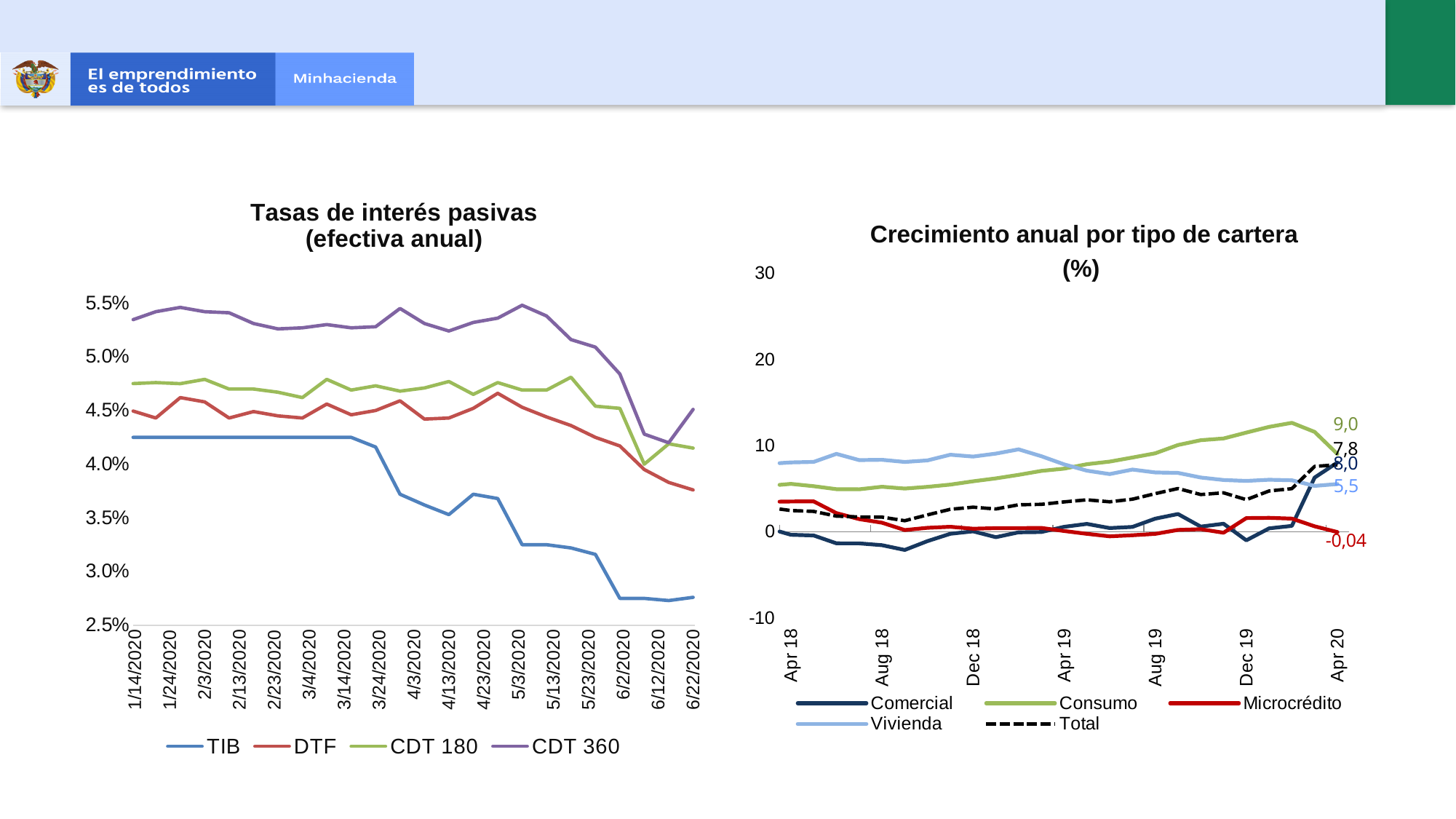
How many series does the legend of the right chart 'Crecimiento anual por tipo de cartera (%)' list? 5 In the right chart 'Crecimiento anual por tipo de cartera (%)', what is the labelled value for Consumo at Apr 20? 9,0 In the right chart 'Crecimiento anual por tipo de cartera (%)', what is the labelled value for Microcrédito at Apr 20? -0,04 In the right chart 'Crecimiento anual por tipo de cartera (%)', which series has the highest value at Apr 20? Consumo In the left chart 'Tasas de interés pasivas', is the TIB value at 6/22/2020 greater or less than 3.0%? less In the right chart 'Crecimiento anual por tipo de cartera (%)', which series has the lowest value at Apr 20? Microcrédito In the right chart 'Crecimiento anual por tipo de cartera (%)', what is the difference between the Consumo and Vivienda values at Apr 20? 3,5 In the right chart 'Crecimiento anual por tipo de cartera (%)', what is the labelled value for Vivienda at Apr 20? 5,5 How many series does the legend of the left chart 'Tasas de interés pasivas' list? 4 In the left chart 'Tasas de interés pasivas', which series has the lowest value at 6/22/2020? TIB What kind of chart is the 'Tasas de interés pasivas (efectiva anual)' chart on the left? Line chart In the left chart 'Tasas de interés pasivas', does the TIB series rise or fall from 1/14/2020 to 6/22/2020? Fall